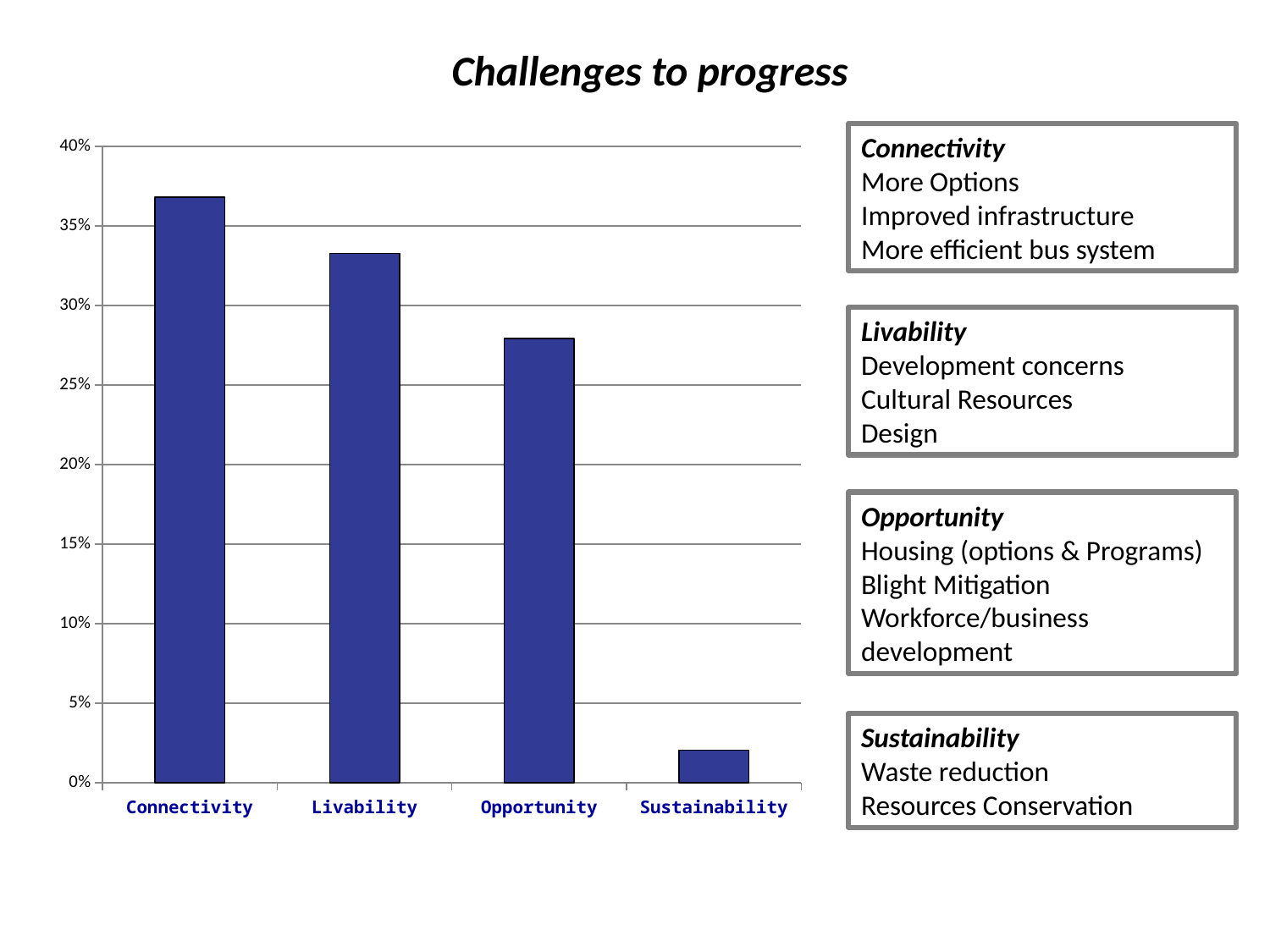
Which category has the highest bar in the chart? Connectivity What kind of chart is shown on the slide? bar chart Do the bar values rise or fall from left to right along the x axis? fall Which is larger, the value for Livability or the value for Opportunity? Livability Is the value for Livability greater or less than 30%? greater Is the value for Opportunity greater or less than 30%? less Is the value for Connectivity greater or less than 35%? greater What is the title shown above the chart on the slide? Challenges to progress What is the highest value shown on the chart's y axis? 40% Which category has the lowest bar in the chart? Sustainability How many categories are shown on the x axis of the chart? 4